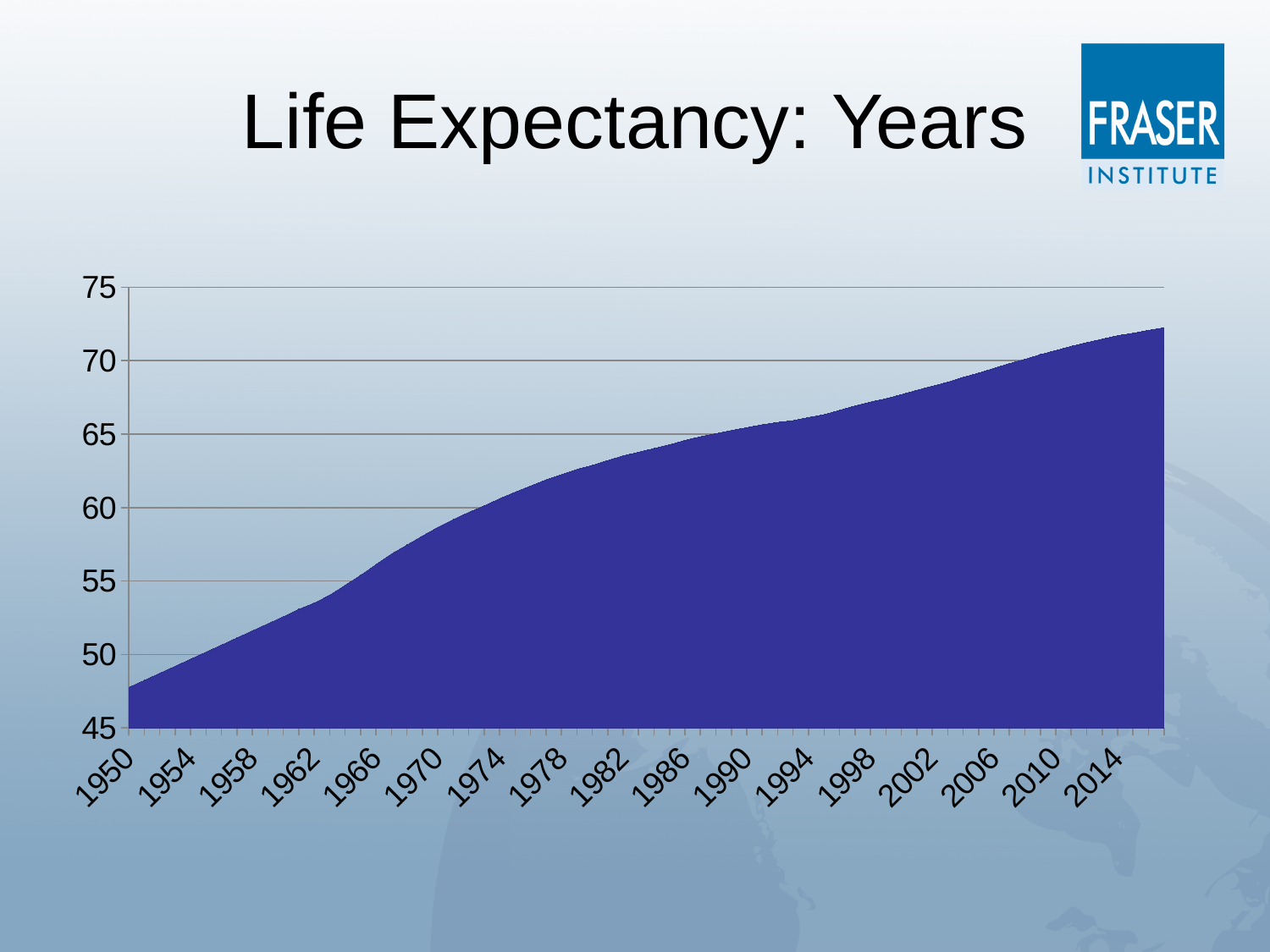
Is the value for 1962 greater or less than 55? less Which labelled year has the lowest life expectancy? 1950 Is the value for 1998 greater or less than 65? greater What kind of chart is shown on the slide? area chart Which is larger, the value for 1974 or the value for 1958? 1974 Is the value for 2014 greater or less than 70? greater Do the values rise or fall from 1950 to 2014? rise What is the title of the chart? Life Expectancy: Years How many year labels are shown on the x axis? 17